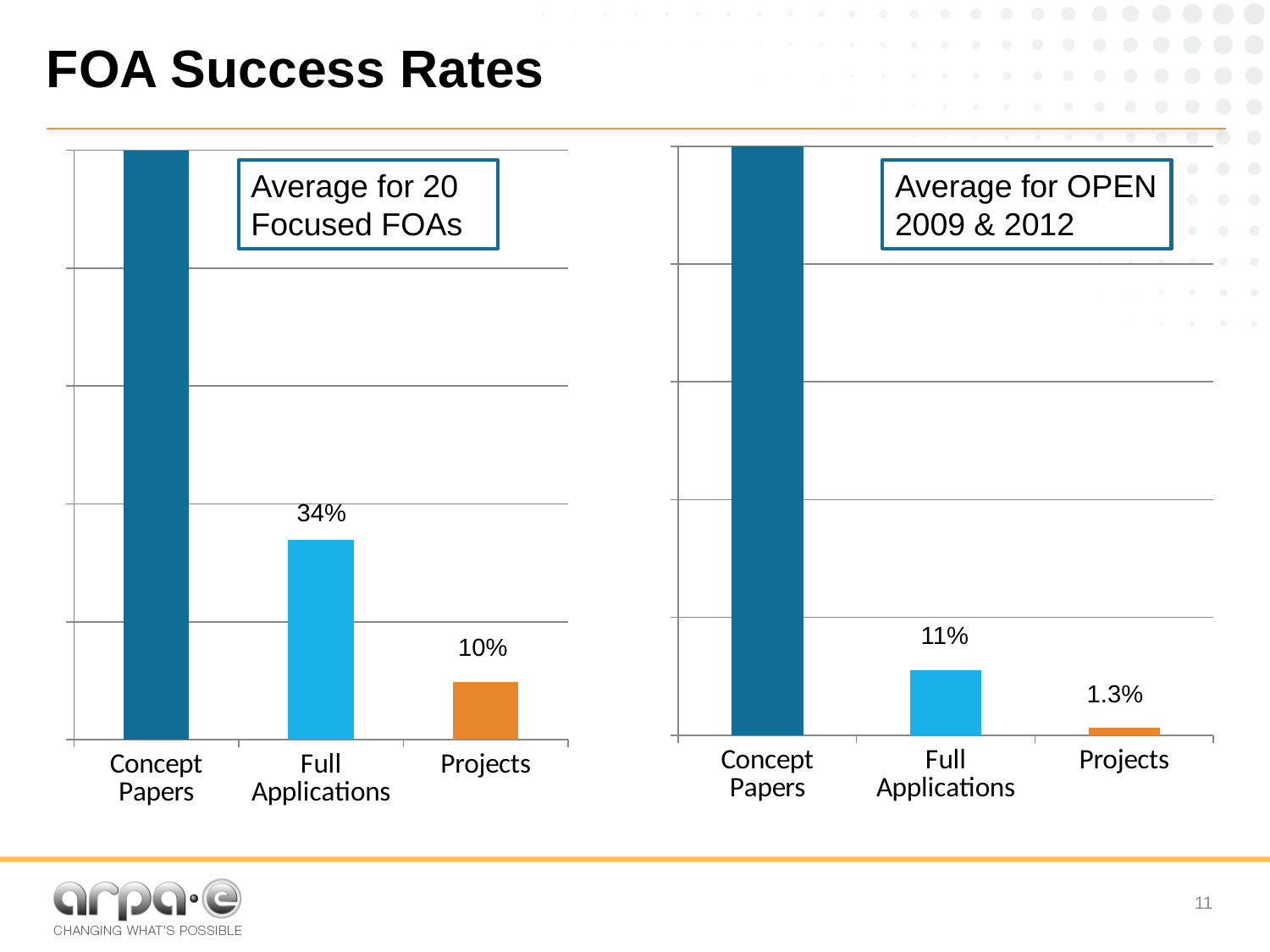
In the left chart (Average for 20 Focused FOAs), what is the value for Full Applications? 34% In the left chart (Average for 20 Focused FOAs), do the values rise or fall from Concept Papers to Projects? Fall What type of chart is the left chart (Average for 20 Focused FOAs)? Bar chart In the left chart (Average for 20 Focused FOAs), what is the difference between the Full Applications and Projects values? 24 percentage points In the right chart (Average for OPEN 2009 & 2012), what is the value for Projects? 1.3% In the right chart (Average for OPEN 2009 & 2012), what is the difference between the Full Applications and Projects values? 9.7 percentage points In the left chart (Average for 20 Focused FOAs), what is the value for Projects? 10% Is the Full Applications value larger in the left chart (Average for 20 Focused FOAs) or the right chart (Average for OPEN 2009 & 2012)? Left chart (34%) In the right chart (Average for OPEN 2009 & 2012), what is the value for Full Applications? 11% In the left chart (Average for 20 Focused FOAs), which category has the highest bar? Concept Papers How many categories are shown in the right chart (Average for OPEN 2009 & 2012)? 3 In the right chart (Average for OPEN 2009 & 2012), which category has the lowest value? Projects